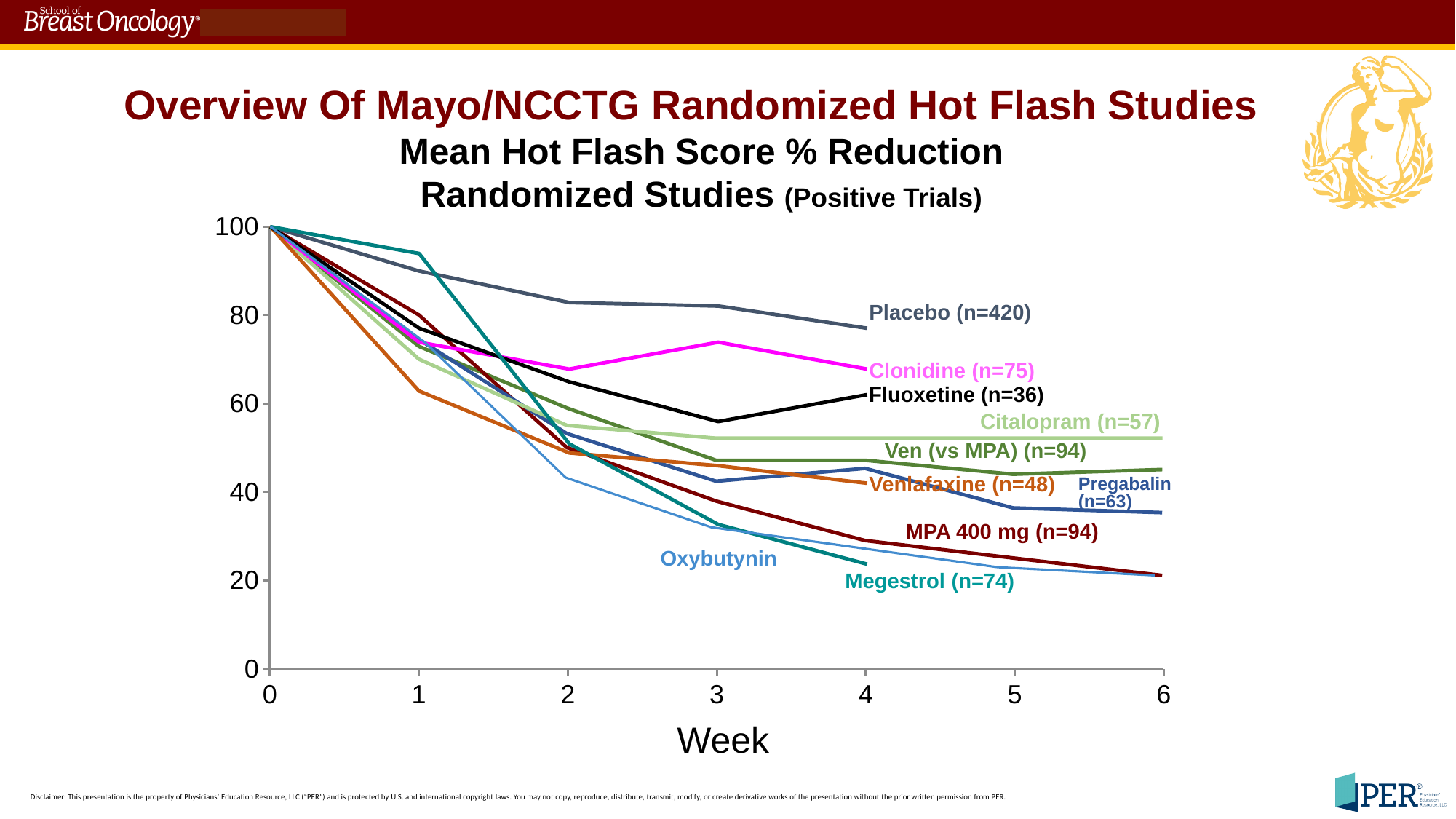
How many treatment series are labelled on the chart? 10 What is the value for Placebo (n=420) at week 0? 100 At week 3, which is larger: the value for Clonidine (n=75) or the value for MPA 400 mg (n=94)? Clonidine (n=75) Does the Placebo (n=420) line rise or fall from week 0 to week 4? fall At week 4, which is larger: the value for Placebo (n=420) or the value for Megestrol (n=74)? Placebo (n=420) What kind of chart is shown on the slide? line chart Is the value for Placebo (n=420) at week 4 greater or less than 60? greater Which series has the highest value at week 4? Placebo (n=420) Is the value for Megestrol (n=74) at week 4 greater or less than 40? less What is the title of the x axis? Week Is the value for MPA 400 mg (n=94) at week 6 greater or less than 40? less